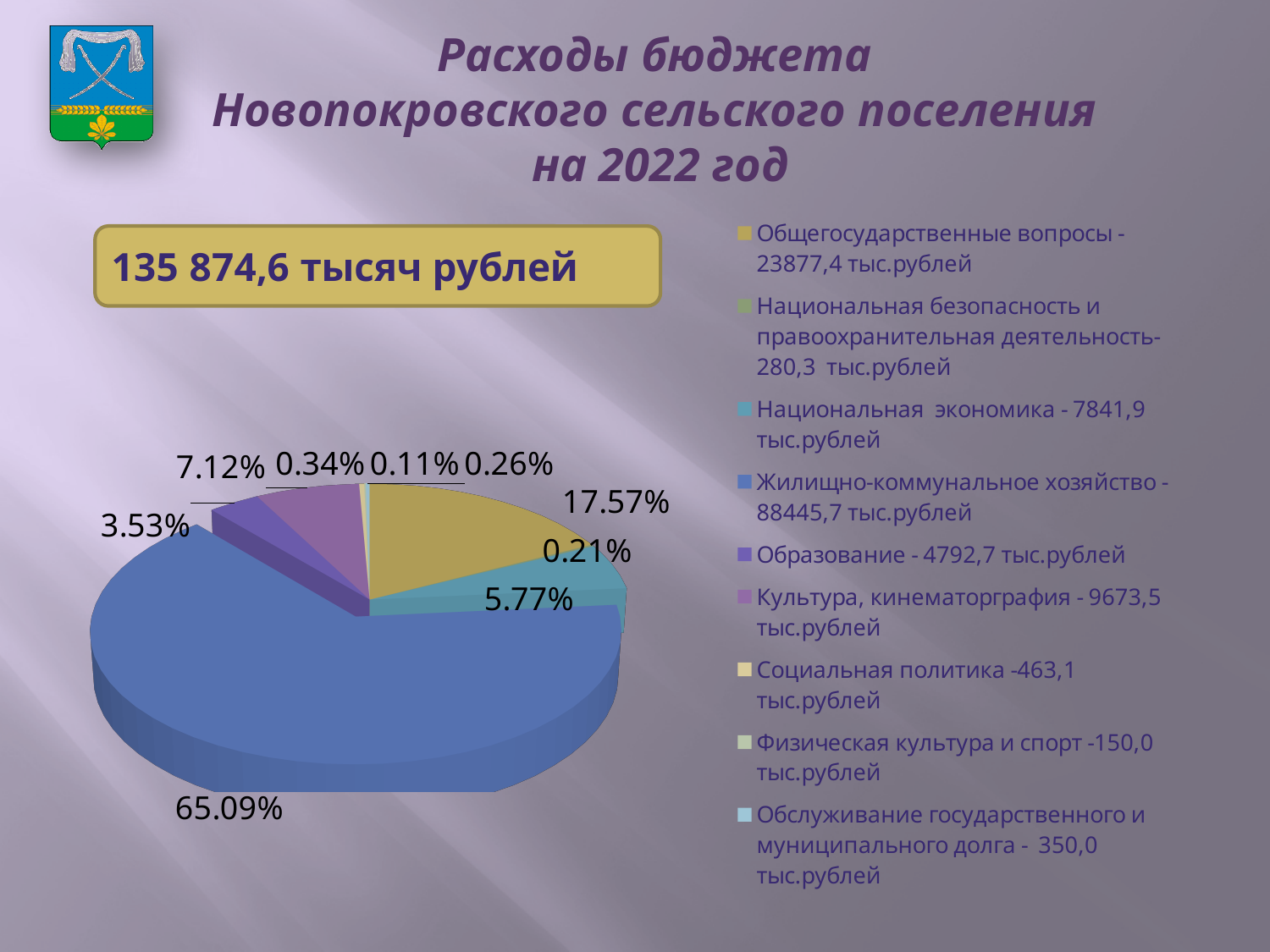
How many categories does the legend of the pie chart list? 9 What total budget expenditure is shown in the box on the slide? 135 874,6 тысяч рублей What is the largest percentage label shown on the pie chart? 65.09% What share of the pie does Национальная экономика have? 5.77% Which category has the smallest share of the pie chart? Физическая культура и спорт According to the legend, what is the amount for Культура, кинематорграфия? 9673,5 тыс.рублей What share of the pie does Общегосударственные вопросы have? 17.57% What is the smallest percentage label shown on the pie chart? 0.11% What is the difference in percentage points between the 65.09% slice and the 17.57% slice? 47.52 Which category has the largest share of the pie chart? Жилищно-коммунальное хозяйство What kind of chart is shown on the slide? pie chart According to the legend, what is the amount for Образование? 4792,7 тыс.рублей